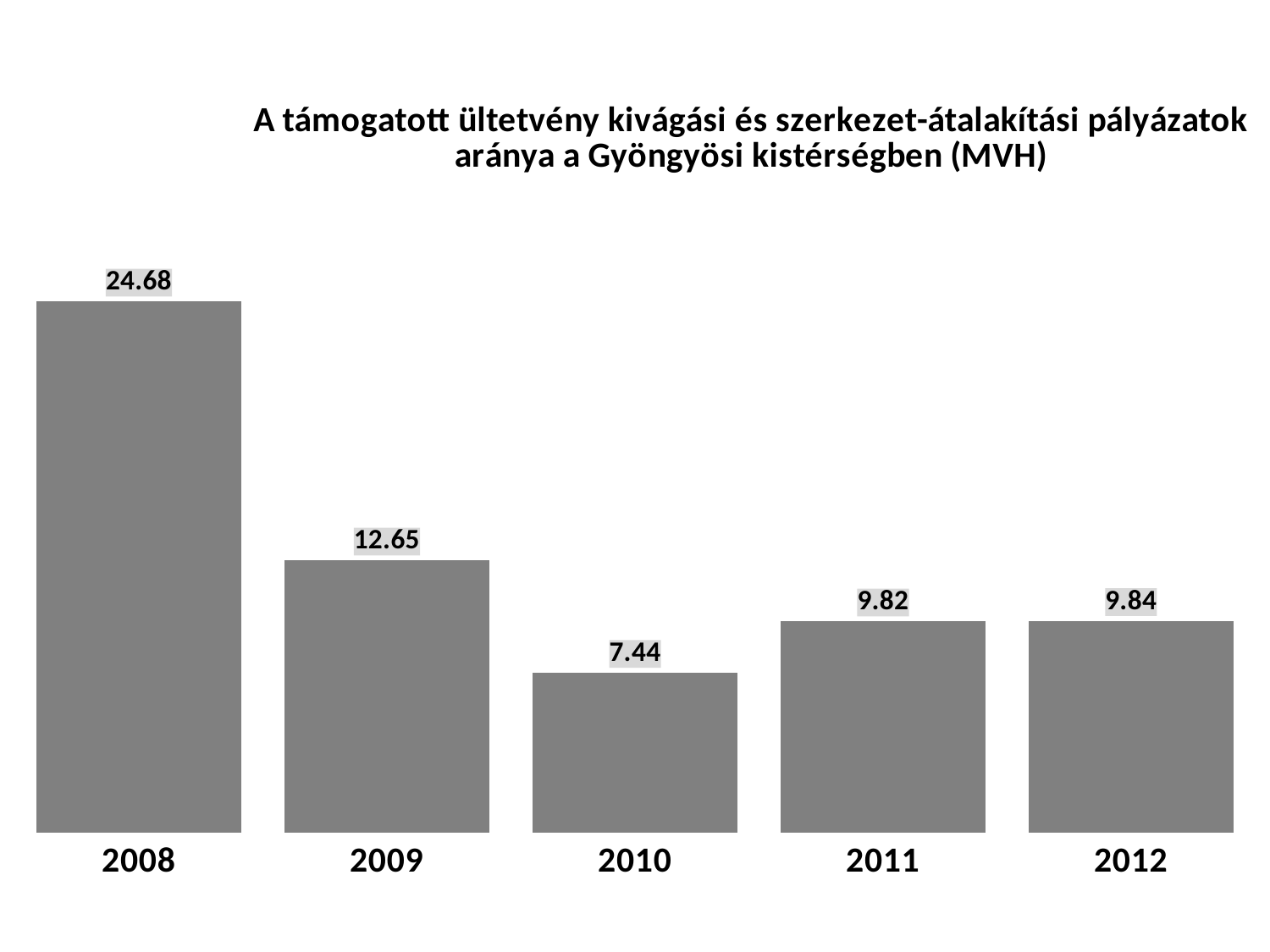
How many years are shown on the x axis? 5 Do the values rise or fall from 2008 to 2010? fall What is the value for 2010? 7.44 What is the difference between the values for 2008 and 2009? 12.03 Which year has the lowest value? 2010 What is the value for 2008? 24.68 What is the value for 2012? 9.84 What is the title of the chart? A támogatott ültetvény kivágási és szerkezet-átalakítási pályázatok aránya a Gyöngyösi kistérségben (MVH) What kind of chart is shown on the slide? bar chart Which year has the highest value? 2008 What is the difference between the values for 2011 and 2010? 2.38 Which is larger, the value for 2009 or the value for 2011? 2009